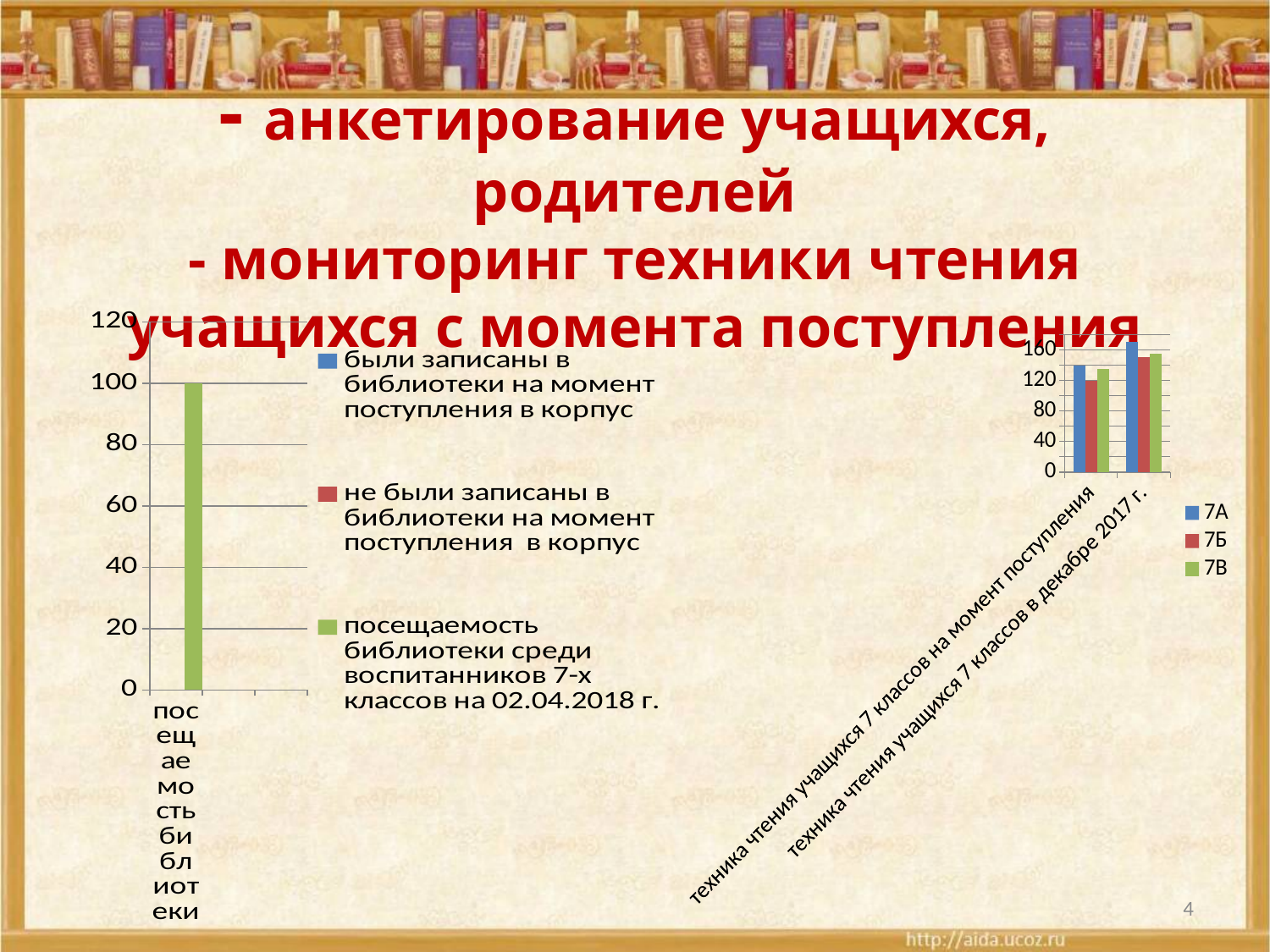
In the left chart, what is the value of the bar for посещаемость библиотеки? 100 In the right chart (техника чтения), is the value for 7Б на момент поступления greater or less than 140? less How many categories are shown on the x axis of the right chart (техника чтения)? 2 In the left chart, what colour is the bar for посещаемость библиотеки среди воспитанников 7-х классов на 02.04.2018 г.? green In the right chart (техника чтения), which class has the lowest value на момент поступления? 7Б In the right chart (техника чтения), do the values for 7Б rise or fall from на момент поступления to декабре 2017 г.? rise How many entries does the legend of the left chart list? 3 How many series does the legend of the right chart (техника чтения) list? 3 What kind of chart is the chart on the left of the slide? bar chart In the right chart (техника чтения), which is larger на момент поступления: 7А or 7Б? 7А In the right chart (техника чтения), is the value for 7А в декабре 2017 г. greater or less than 160? greater In the right chart (техника чтения), which class has the highest value for декабре 2017 г.? 7А